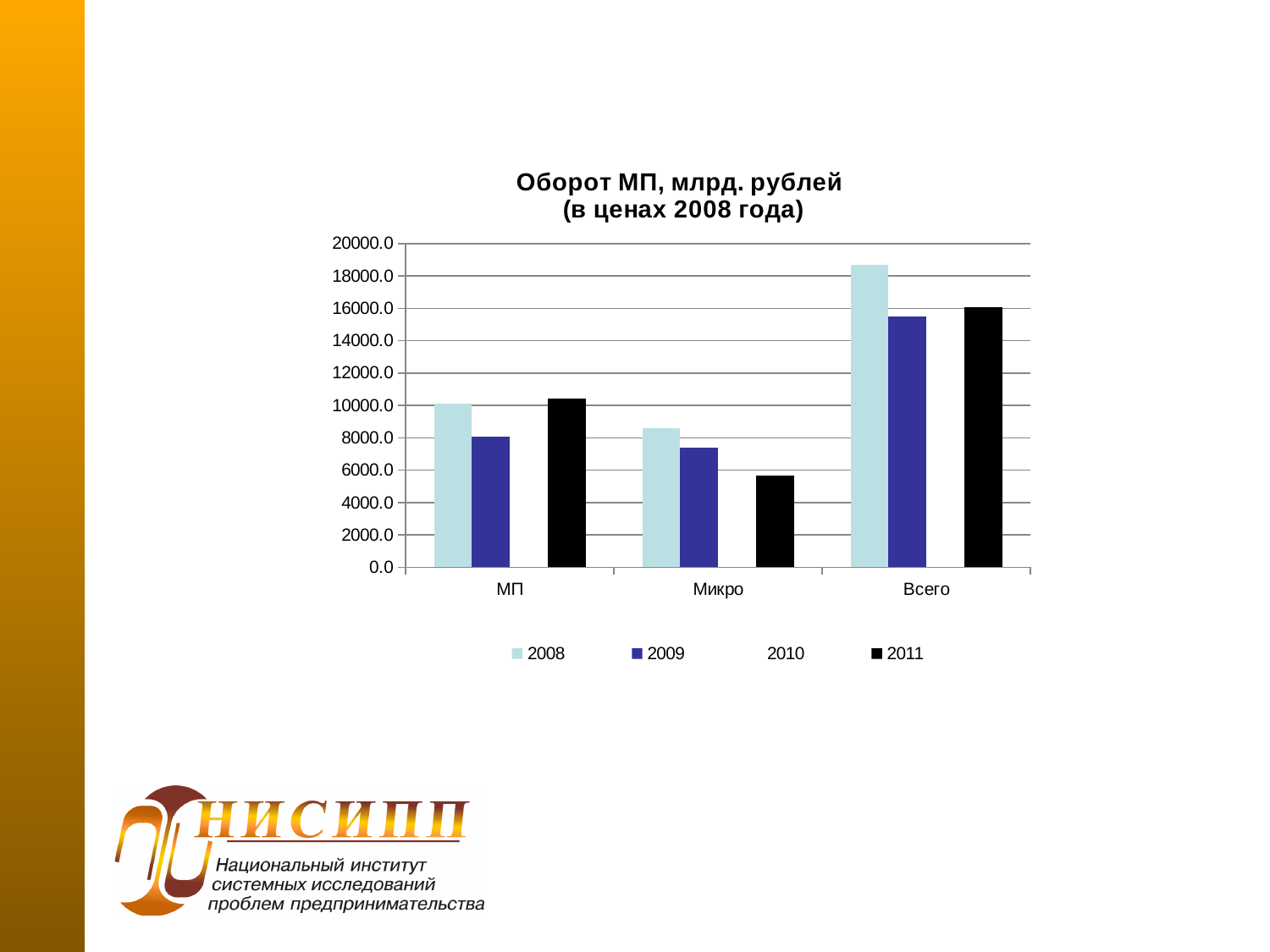
How many categories are shown on the x axis of the chart? 3 For the category МП, which year has the lowest value? 2009 Is the value for 2008 in the category Всего greater or less than 18000? greater For the category Всего, which year has the highest value? 2008 What is the title of the chart? Оборот МП, млрд. рублей (в ценах 2008 года) Is the value for 2011 in the category Микро greater or less than 6000? less How many series does the legend list? 4 Which category has the tallest bar in the chart? Всего What kind of chart is shown on the slide? bar chart In the category Микро, which is larger: the value for 2008 or the value for 2011? 2008 Is the value for 2009 in the category МП greater or less than 10000? less